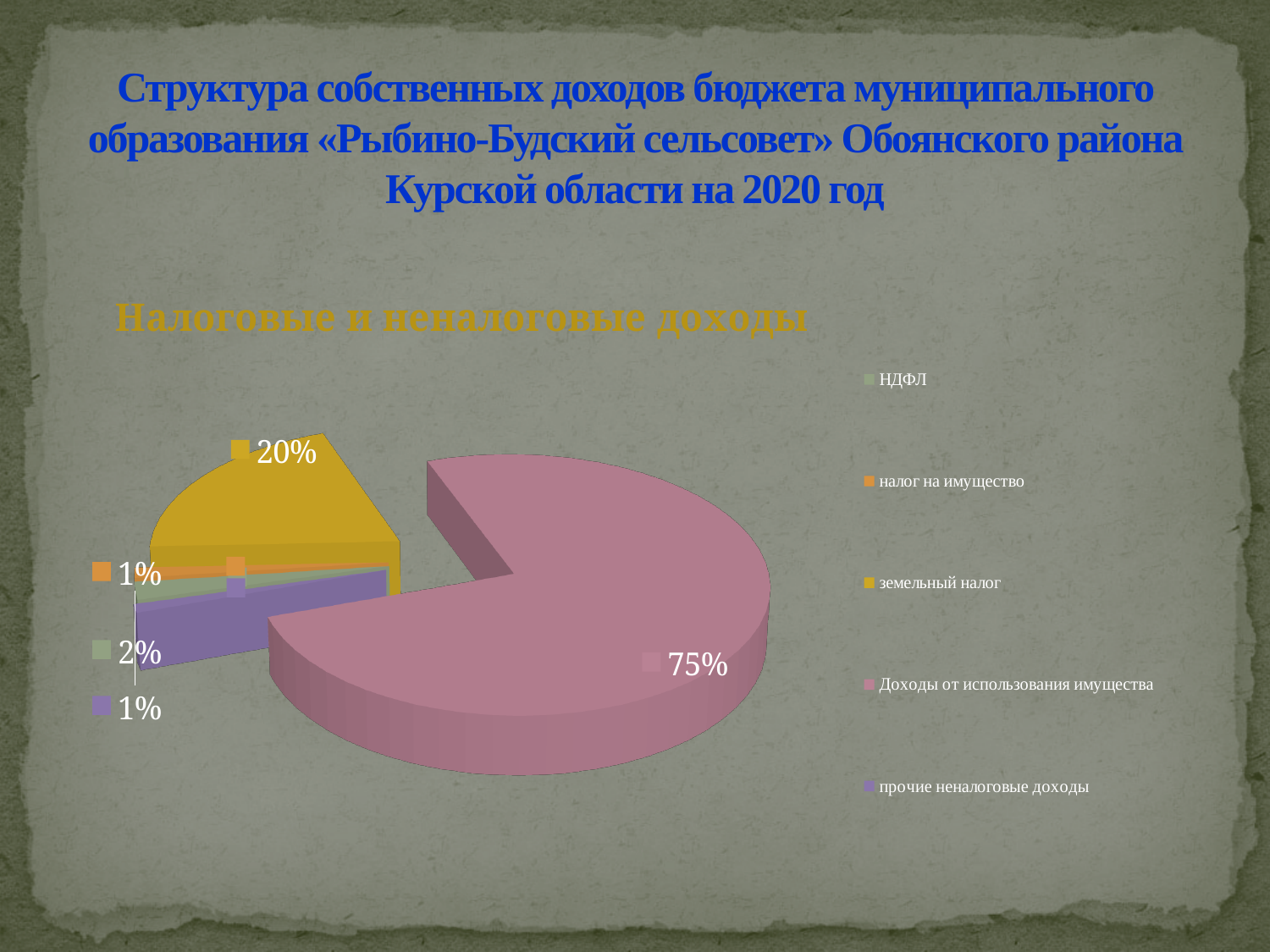
Which category has the largest share of the pie? Доходы от использования имущества Which is larger, the share for земельный налог or the share for НДФЛ? земельный налог What share of the pie is налог на имущество? 1% What is the chart's title? Налоговые и неналоговые доходы What share of the pie is Доходы от использования имущества? 75% How many categories does the legend list? 5 What share of the pie is НДФЛ? 2% What is the combined share of земельный налог and НДФЛ? 22% What is the difference in percentage points between Доходы от использования имущества and земельный налог? 55 Which legend entry is shown in pink? Доходы от использования имущества What kind of chart is shown on the slide? pie chart